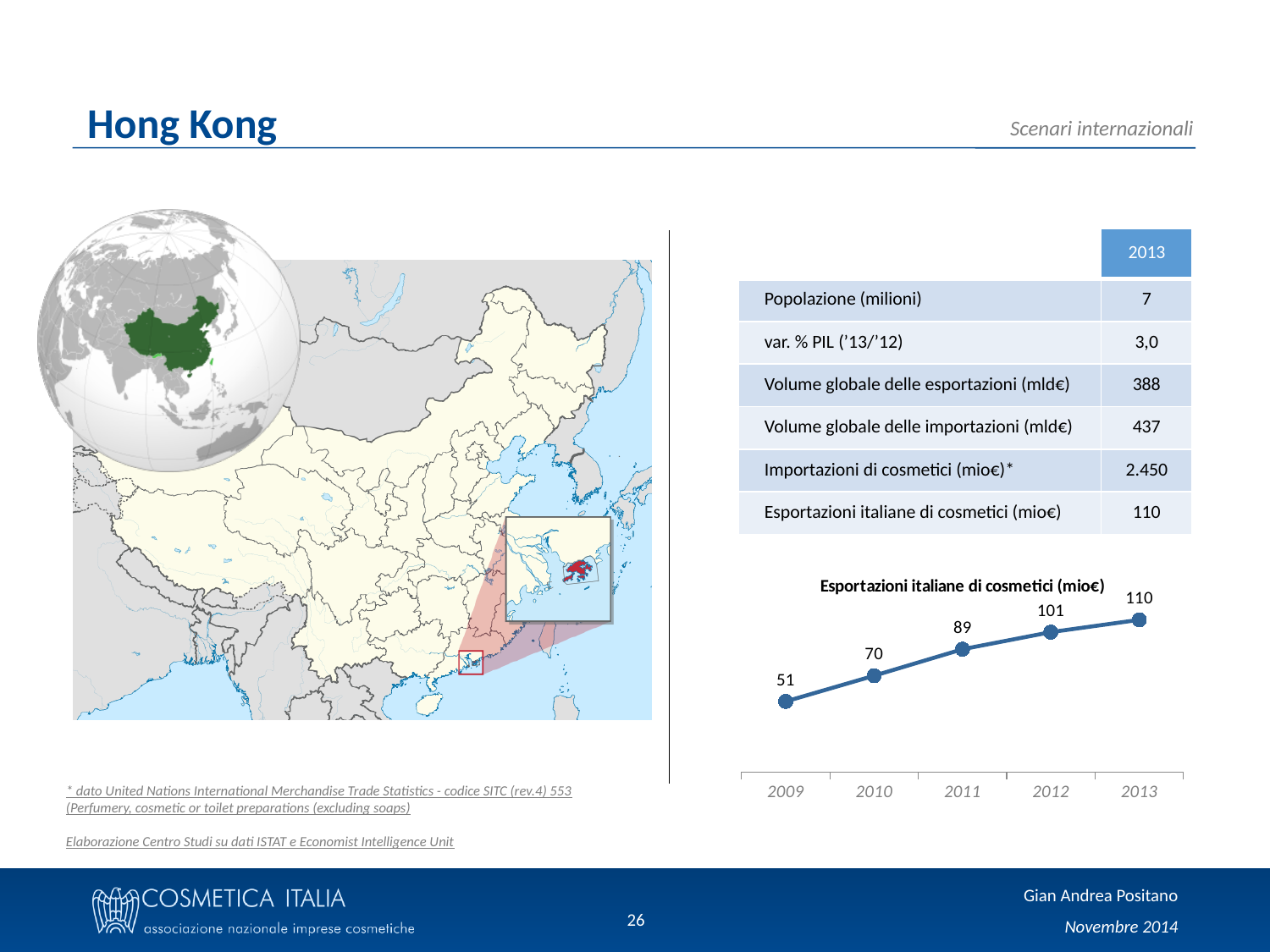
Which is larger in the chart 'Esportazioni italiane di cosmetici (mio€)': the value for 2010 or the value for 2012? 2012 What is the title of the chart on the slide? Esportazioni italiane di cosmetici (mio€) What kind of chart is 'Esportazioni italiane di cosmetici (mio€)'? Line chart Which year has the lowest value in the chart 'Esportazioni italiane di cosmetici (mio€)'? 2009 What is the value for 2009 in the chart 'Esportazioni italiane di cosmetici (mio€)'? 51 How many years are plotted in the chart 'Esportazioni italiane di cosmetici (mio€)'? 5 What is the value for 2013 in the chart 'Esportazioni italiane di cosmetici (mio€)'? 110 What is the difference between the 2012 and 2011 values in the chart 'Esportazioni italiane di cosmetici (mio€)'? 12 What is the difference between the 2013 and 2009 values in the chart 'Esportazioni italiane di cosmetici (mio€)'? 59 Do the values in the chart 'Esportazioni italiane di cosmetici (mio€)' rise or fall from 2009 to 2013? Rise What is the value for 2011 in the chart 'Esportazioni italiane di cosmetici (mio€)'? 89 Which year has the highest value in the chart 'Esportazioni italiane di cosmetici (mio€)'? 2013